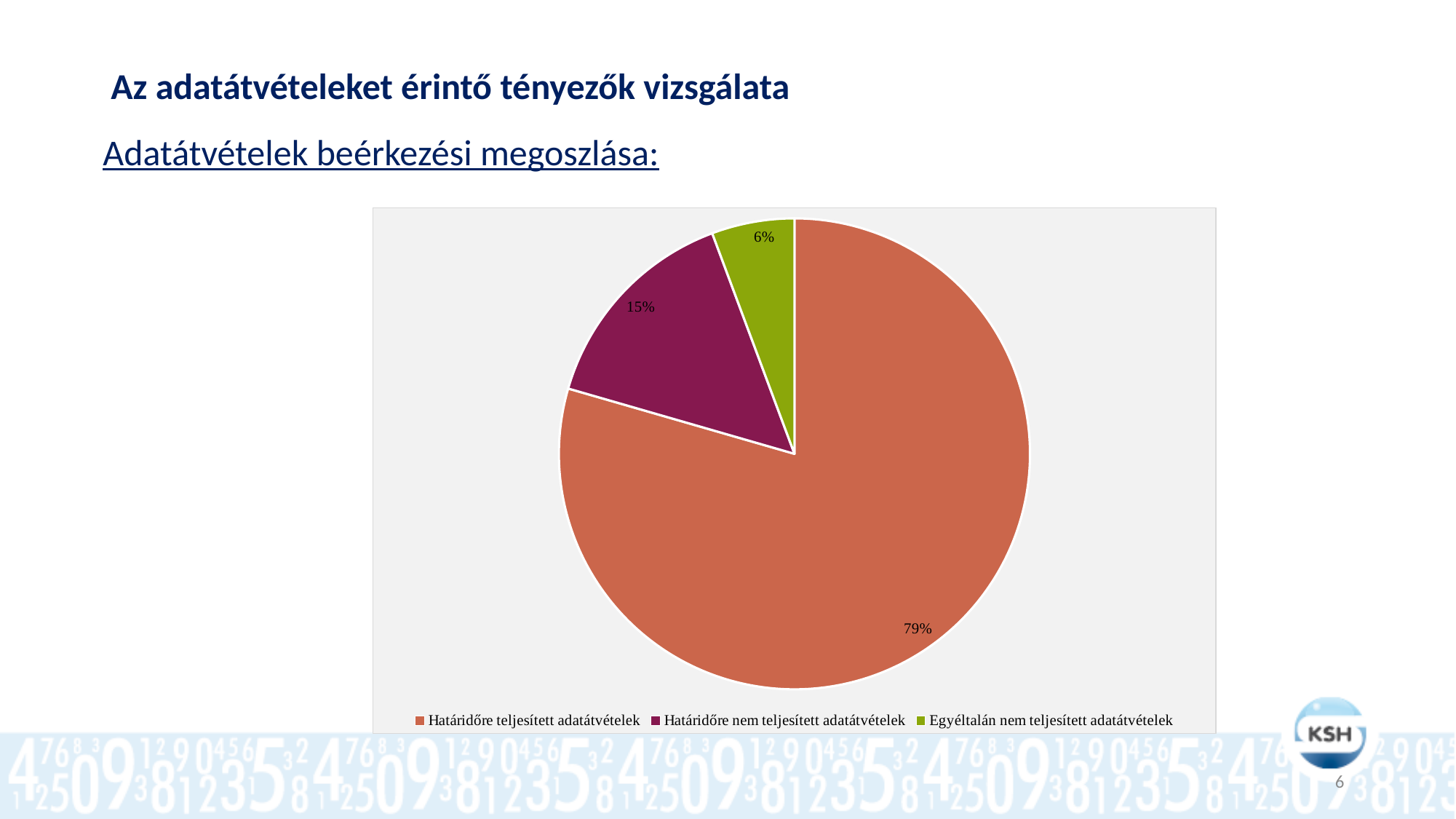
What colour is the slice for 'Egyáltalán nem teljesített adatátvételek'? green Which category has the largest slice of the pie? Határidőre teljesített adatátvételek What share of the pie is 'Egyáltalán nem teljesített adatátvételek'? 6% What is the difference in percentage points between 'Határidőre nem teljesített adatátvételek' and 'Egyáltalán nem teljesített adatátvételek'? 9 percentage points What is the difference in percentage points between 'Határidőre teljesített adatátvételek' and 'Határidőre nem teljesített adatátvételek'? 64 percentage points How many categories does the pie chart show? 3 What is the heading written above the pie chart? Adatátvételek beérkezési megoszlása: What share of the pie is 'Határidőre nem teljesített adatátvételek'? 15% What share of the pie is 'Határidőre teljesített adatátvételek'? 79% Which is larger: the share for 'Határidőre nem teljesített adatátvételek' or for 'Egyáltalán nem teljesített adatátvételek'? Határidőre nem teljesített adatátvételek Which category has the smallest slice of the pie? Egyáltalán nem teljesített adatátvételek What kind of chart is shown on the slide? pie chart